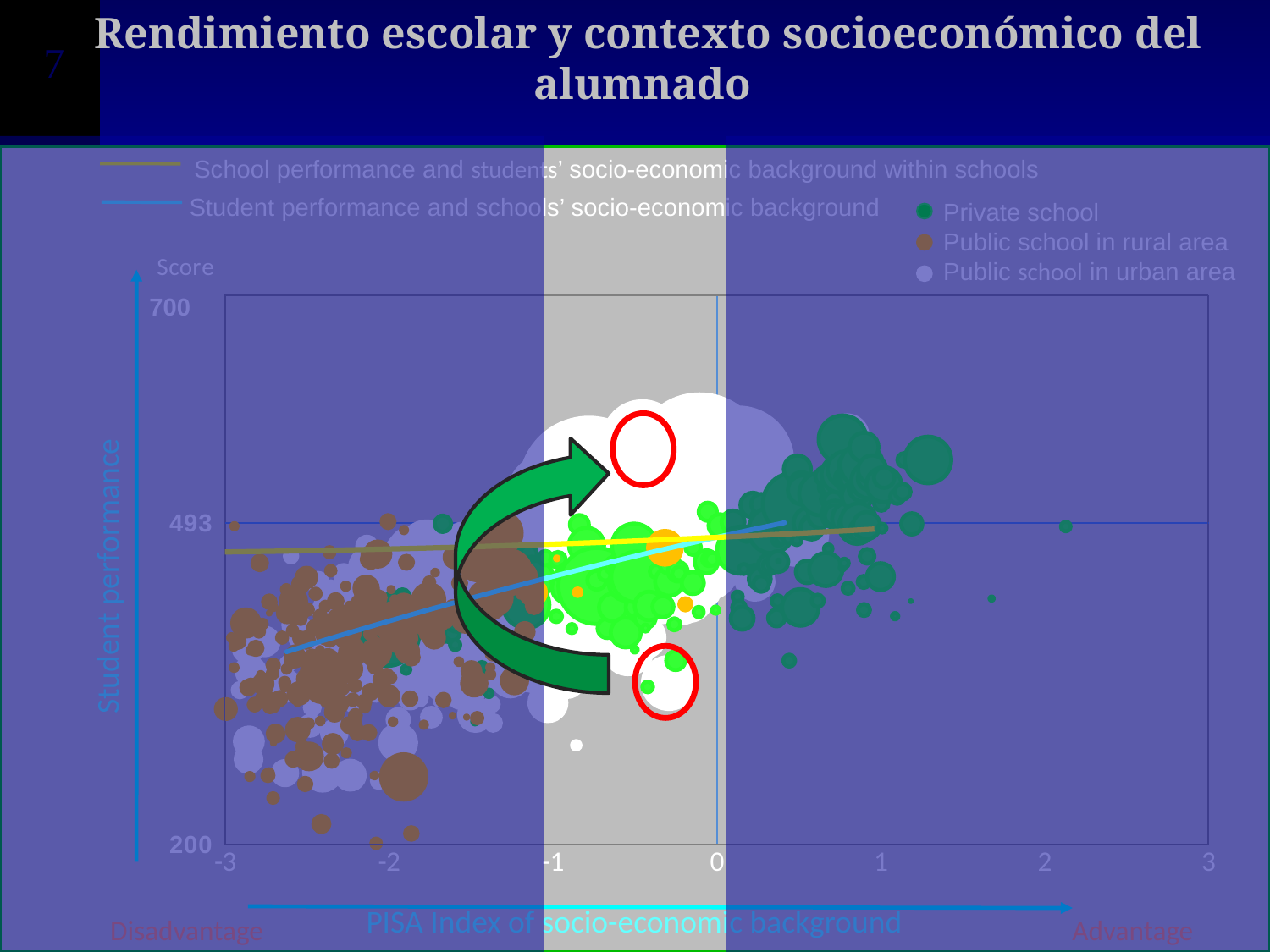
What is the lowest value labelled on the vertical Score axis? 200 How many tick values are labelled on the horizontal axis? 7 What is the label of the horizontal axis? PISA Index of socio-economic background What middle value is labelled on the vertical Score axis between 200 and 700? 493 What kind of chart is shown on the slide? Scatter (bubble) chart Does the blue trend line for 'Student performance and schools' socio-economic background' rise or fall as the PISA index increases from -3 to 3? Rise Which group of bubbles lies mostly to the right of 0 on the PISA index: private schools or public schools in rural areas? Private schools Which colour represents 'Private school' in the legend? Green How many school types does the legend list with coloured dots? 3 What is the highest value labelled on the vertical Score axis? 700